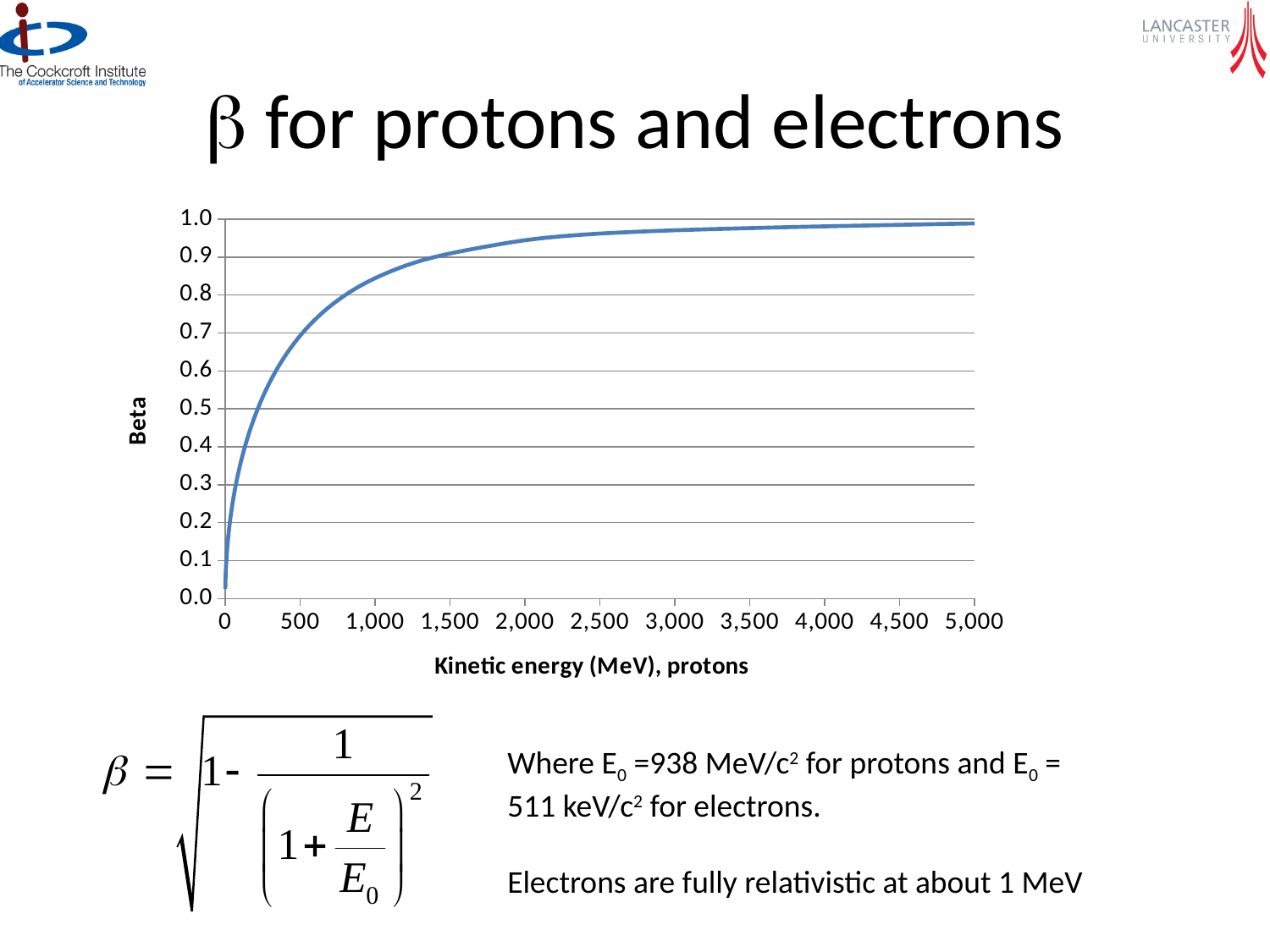
What is the highest value shown on the y axis of the chart? 1.0 What is the label of the x axis of the chart? Kinetic energy (MeV), protons Is Beta larger at 1,000 MeV or at 500 MeV? 1,000 MeV Is the value of Beta at 100 MeV greater or less than 0.6? less Does Beta rise or fall as kinetic energy increases along the x axis? rise What kind of chart is shown on the slide? line chart What is the label of the y axis of the chart? Beta Is the value of Beta at 1,000 MeV greater or less than 0.8? greater At which kinetic energy shown on the x axis is Beta lowest? 0 Is the value of Beta at 2,000 MeV greater or less than 0.9? greater At which kinetic energy shown on the x axis is Beta highest? 5,000